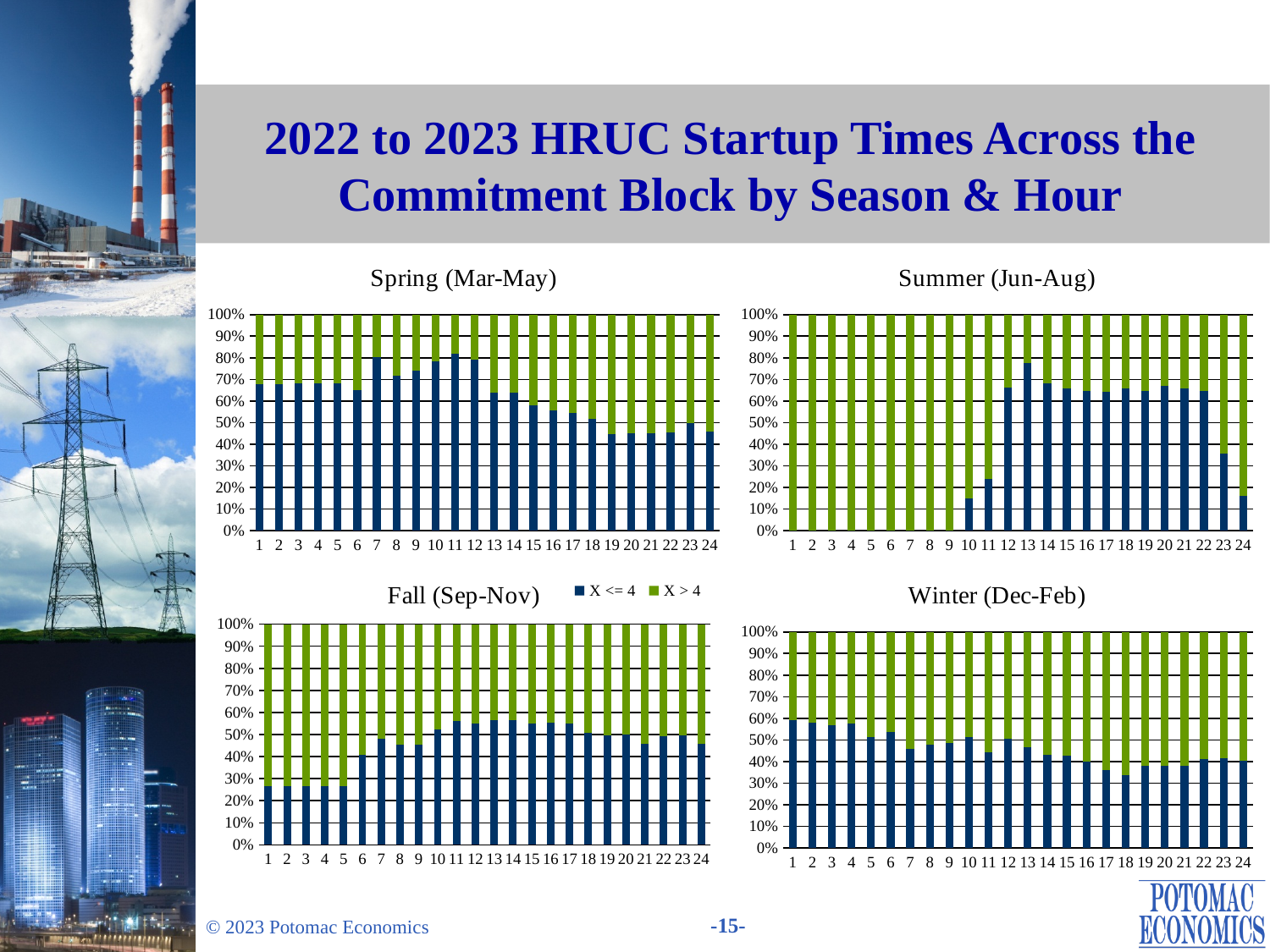
In the Fall (Sep-Nov) chart, is the X <= 4 share at hour 1 greater or less than 40%? less In the Summer (Jun-Aug) chart, is the X <= 4 share at hour 10 greater or less than 20%? less In the Winter (Dec-Feb) chart, is the X <= 4 share at hour 1 greater or less than 50%? greater How many series does the legend list for the charts? 2 In the Summer (Jun-Aug) chart, which hour has the highest share for X <= 4? 13 What are the two series named in the legend? X <= 4 and X > 4 How many hours (categories) are shown on the x axis of the Winter (Dec-Feb) chart? 24 In the Winter (Dec-Feb) chart, does the X <= 4 share generally rise or fall from hour 1 to hour 24? fall In the Fall (Sep-Nov) chart, is the X <= 4 share at hour 13 larger or smaller than at hour 1? larger What are the titles of the four charts on the slide? Spring (Mar-May), Summer (Jun-Aug), Fall (Sep-Nov), Winter (Dec-Feb) What kind of chart is the Spring (Mar-May) chart? Stacked bar chart